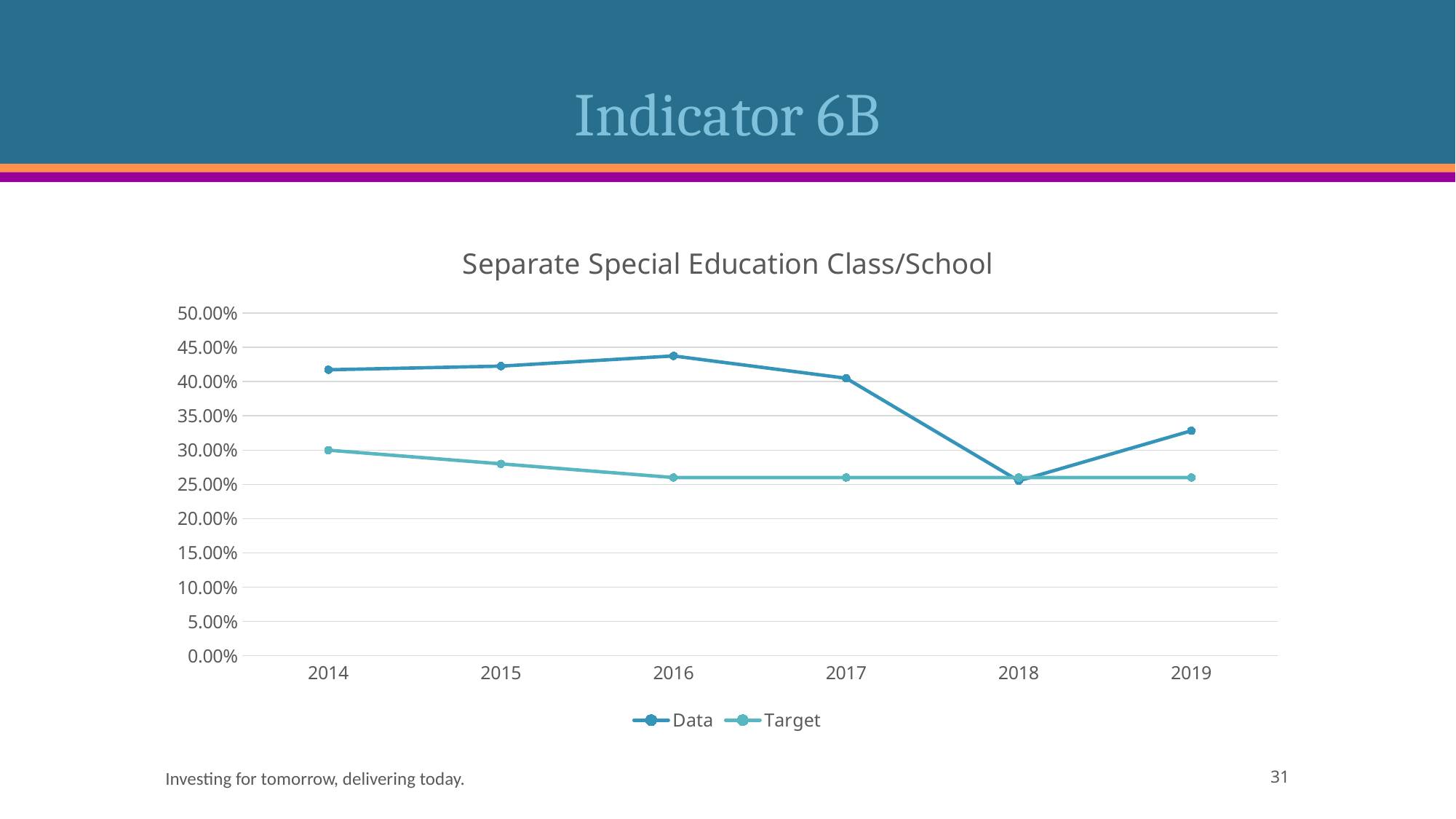
In which year is the Data series at its lowest? 2018 In 2016, which series has the larger value, Data or Target? Data Is the Data value for 2018 greater or less than 30.00%? less What kind of chart is shown on the slide? line chart Is the Target value for 2015 greater or less than 30.00%? less What are the two series named in the legend? Data and Target Is the Data value for 2016 greater or less than 40.00%? greater Does the Data series rise or fall from 2016 to 2018? fall What is the title of the chart? Separate Special Education Class/School In which year is the Data series at its highest? 2016 How many series does the legend list? 2 How many years are shown on the x axis? 6